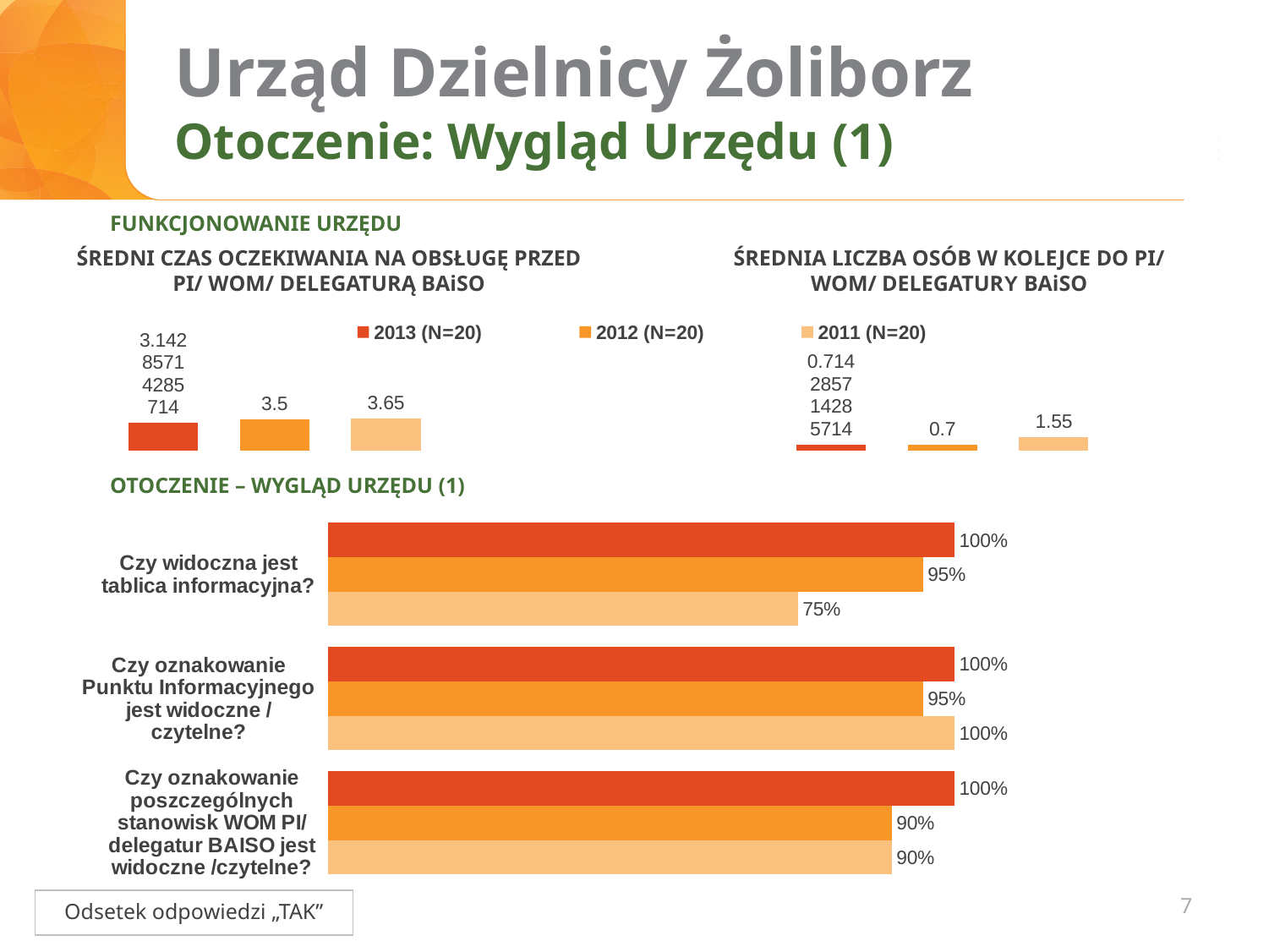
In the chart 'ŚREDNIA LICZBA OSÓB W KOLEJCE DO PI/ WOM/ DELEGATURY BAiSO', what is the value for 2011 (N=20)? 1.55 In the bottom chart 'OTOCZENIE – WYGLĄD URZĘDU (1)', which category has the lowest 2011 (light orange) value? Czy widoczna jest tablica informacyjna? In the chart 'ŚREDNI CZAS OCZEKIWANIA NA OBSŁUGĘ PRZED PI/ WOM/ DELEGATURĄ BAiSO', which year has the highest value? 2011 (N=20) What type of chart is the bottom chart 'OTOCZENIE – WYGLĄD URZĘDU (1)'? Bar chart In the bottom chart 'OTOCZENIE – WYGLĄD URZĘDU (1)', what is the value of the 2013 (red) bar for 'Czy oznakowanie Punktu Informacyjnego jest widoczne / czytelne?'? 100% In the bottom chart 'OTOCZENIE – WYGLĄD URZĘDU (1)', what is the difference between the 2013 (red) and 2011 (light orange) bars for 'Czy widoczna jest tablica informacyjna?'? 25% How many question categories are shown in the bottom chart 'OTOCZENIE – WYGLĄD URZĘDU (1)'? 3 In the bottom chart 'OTOCZENIE – WYGLĄD URZĘDU (1)', what is the value of the 2011 (light orange) bar for 'Czy widoczna jest tablica informacyjna?'? 75% In the bottom chart 'OTOCZENIE – WYGLĄD URZĘDU (1)', what is the value of the 2012 (orange) bar for 'Czy oznakowanie poszczególnych stanowisk WOM PI/ delegatur BAISO jest widoczne /czytelne?'? 90% In the chart 'ŚREDNIA LICZBA OSÓB W KOLEJCE DO PI/ WOM/ DELEGATURY BAiSO', is the value for 2011 (N=20) larger or smaller than the value for 2012 (N=20)? Larger In the chart 'ŚREDNI CZAS OCZEKIWANIA NA OBSŁUGĘ PRZED PI/ WOM/ DELEGATURĄ BAiSO', what is the value for 2012 (N=20)? 3.5 How many series does the legend above the top charts list? 3